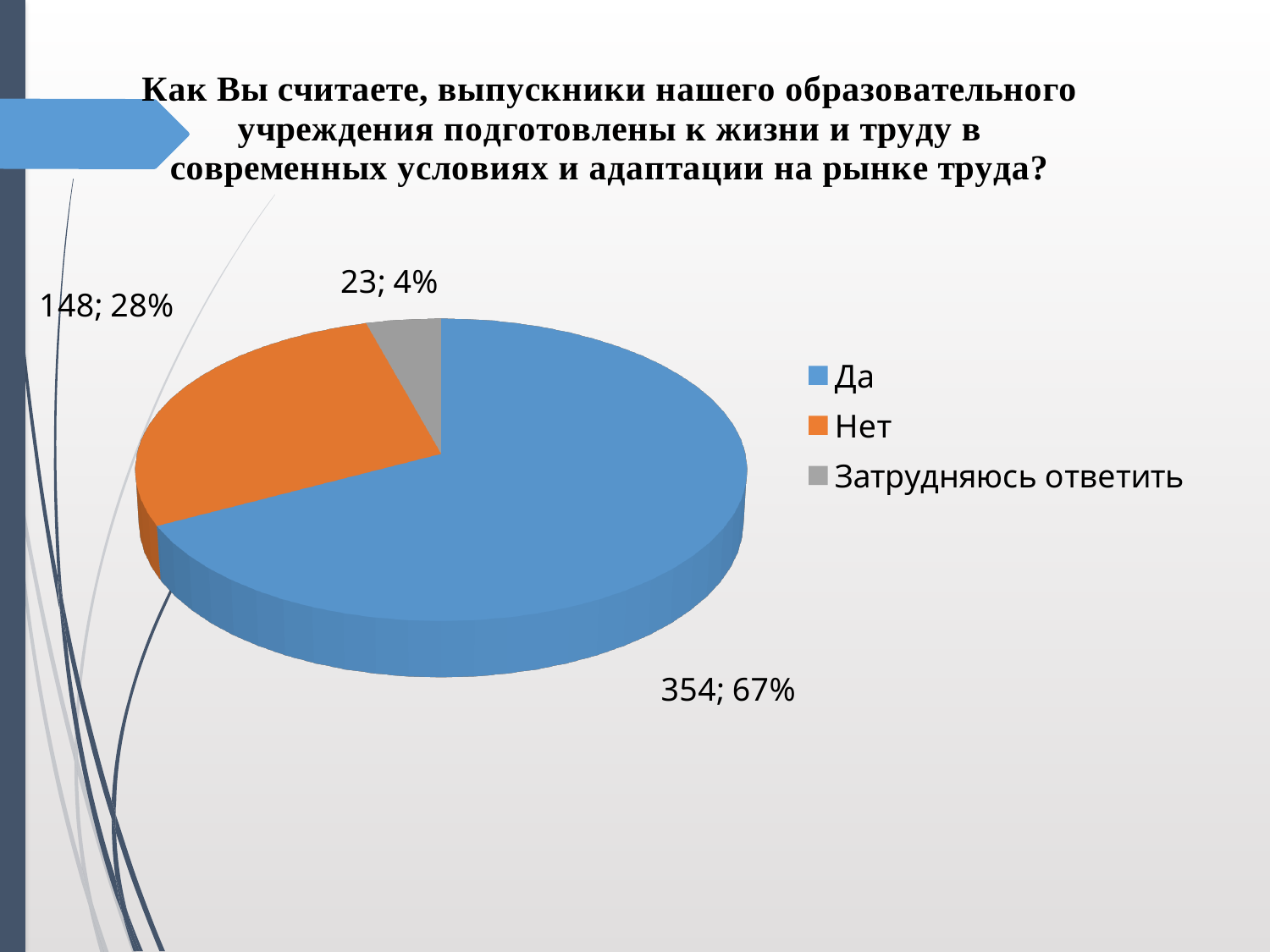
Which category has the largest slice? Да What is the value for "Да"? 354 How many slices does the pie chart have? 3 What is the value for "Затрудняюсь ответить"? 23 What kind of chart is shown on the slide? pie chart Which category has the smallest slice? Затрудняюсь ответить What share of the pie does "Да" represent? 67% What share of the pie does "Нет" represent? 28% What is the value for "Нет"? 148 How many entries does the legend list? 3 Which colour represents "Нет" in the pie chart? orange What is the difference between the values for "Да" and "Нет"? 206